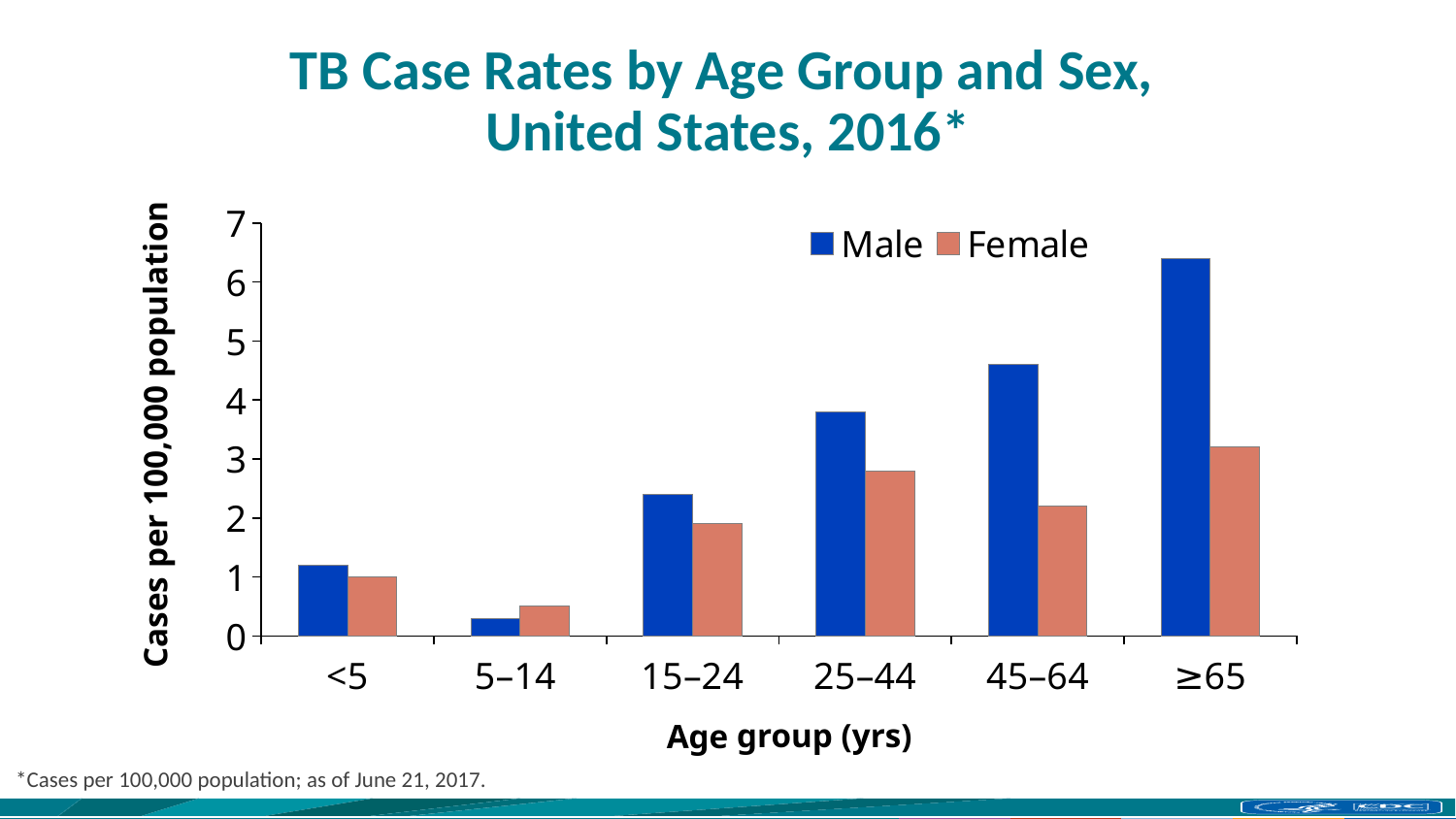
In the 5–14 age group, which is larger, the Male or the Female case rate? Female What kind of chart is shown on the slide? bar chart How many age groups are shown on the x axis? 6 Which age group has the lowest Female TB case rate? 5–14 Does the Male case rate rise or fall from the 5–14 age group to the ≥65 age group? rise In the 45–64 age group, which is larger, the Male or the Female case rate? Male Is the Female case rate for the 25–44 age group greater or less than 3? less Which age group has the highest Male TB case rate? ≥65 Is the Male case rate for the ≥65 age group greater or less than 6? greater Which age group has the lowest Male TB case rate? 5–14 How many series does the legend list? 2 What is the label of the y axis? Cases per 100,000 population